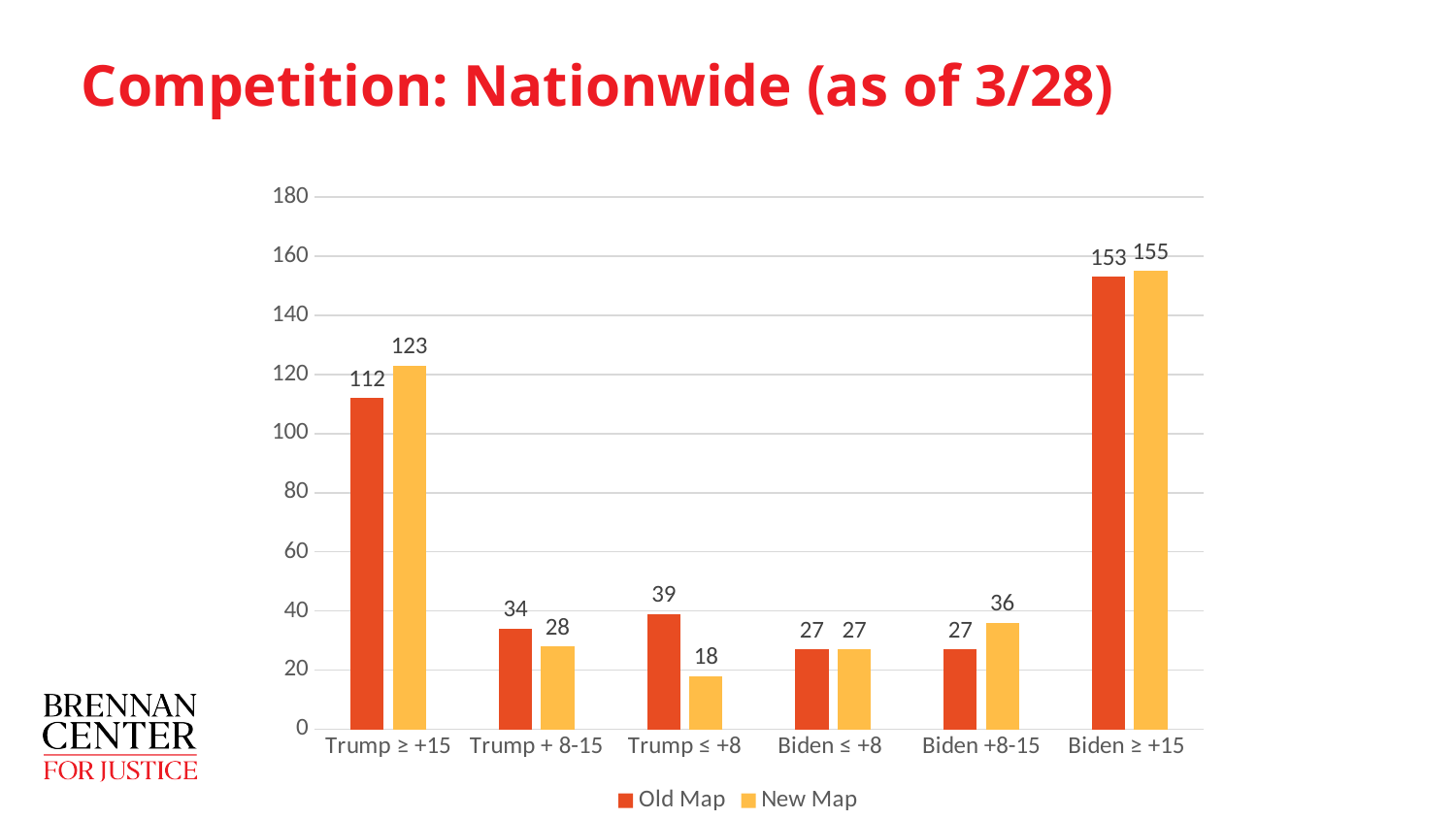
What is the difference between the New Map and Old Map values for Trump ≥ +15? 11 What is the title of the slide? Competition: Nationwide (as of 3/28) How many series does the legend list? 2 What is the New Map value for Trump ≤ +8? 18 What is the New Map value for Biden +8-15? 36 How many categories are shown on the x axis? 6 Is the Old Map value for Biden ≥ +15 greater or less than 140? greater What kind of chart is shown on the slide? Bar chart What is the Old Map value for Trump ≥ +15? 112 Which is larger for Trump + 8-15: the Old Map value or the New Map value? Old Map Which category has the lowest New Map value? Trump ≤ +8 Which category has the highest New Map value? Biden ≥ +15